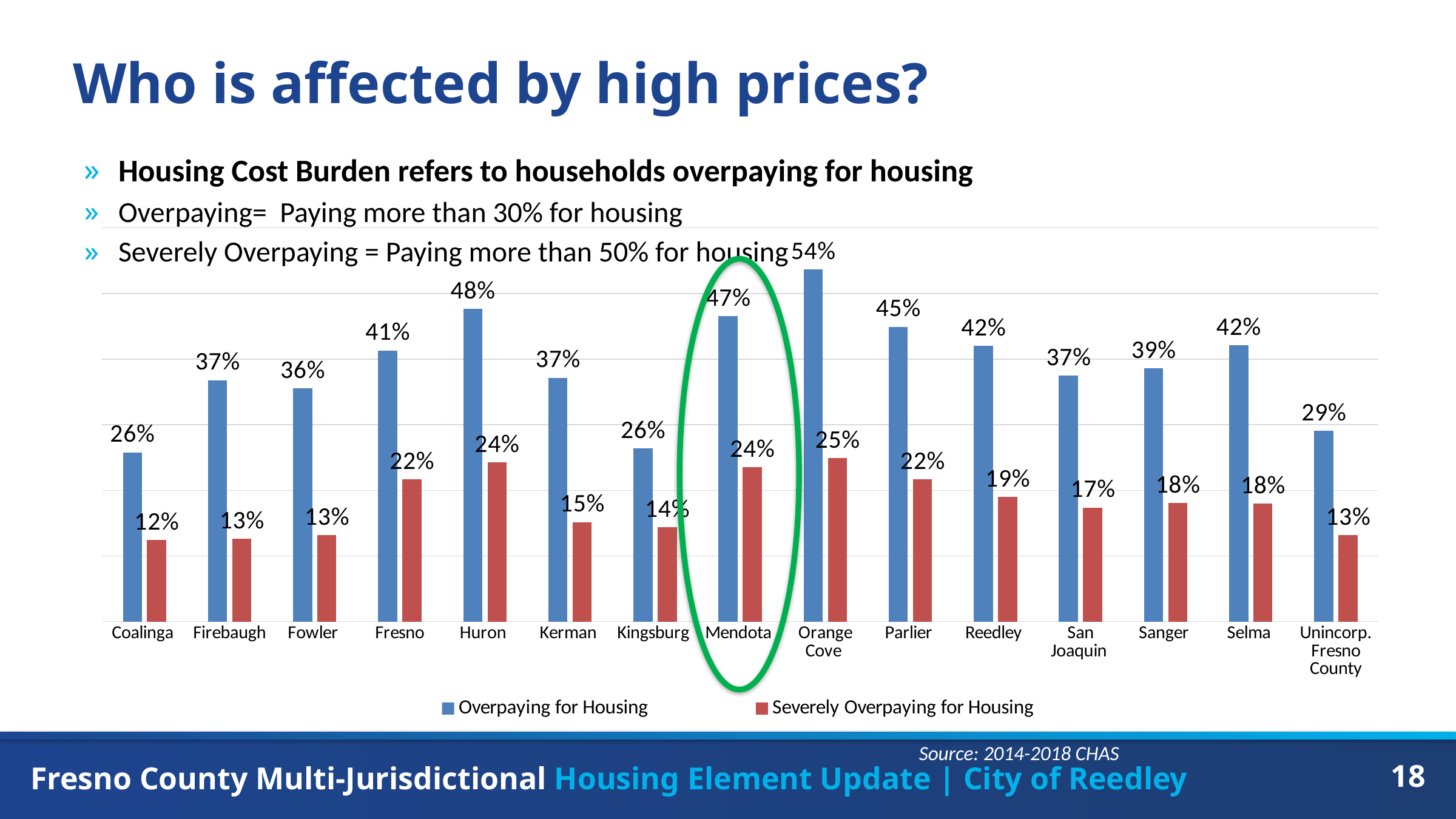
What kind of chart is shown on the slide? Bar chart What is the value for Overpaying for Housing in Unincorp. Fresno County? 29% Which category has the lowest value for Severely Overpaying for Housing? Coalinga Which category has the highest value for Overpaying for Housing? Orange Cove How many series does the legend list? 2 What is the difference between the Overpaying for Housing and Severely Overpaying for Housing values for Huron? 24% How many categories are shown on the x axis? 15 Which is larger, the Severely Overpaying for Housing value for Fresno or for Reedley? Fresno Which category is circled in green on the chart? Mendota What is the difference between the Overpaying for Housing values for Orange Cove and Parlier? 9% What is the value for Severely Overpaying for Housing in Mendota? 24% What is the value for Overpaying for Housing in Reedley? 42%